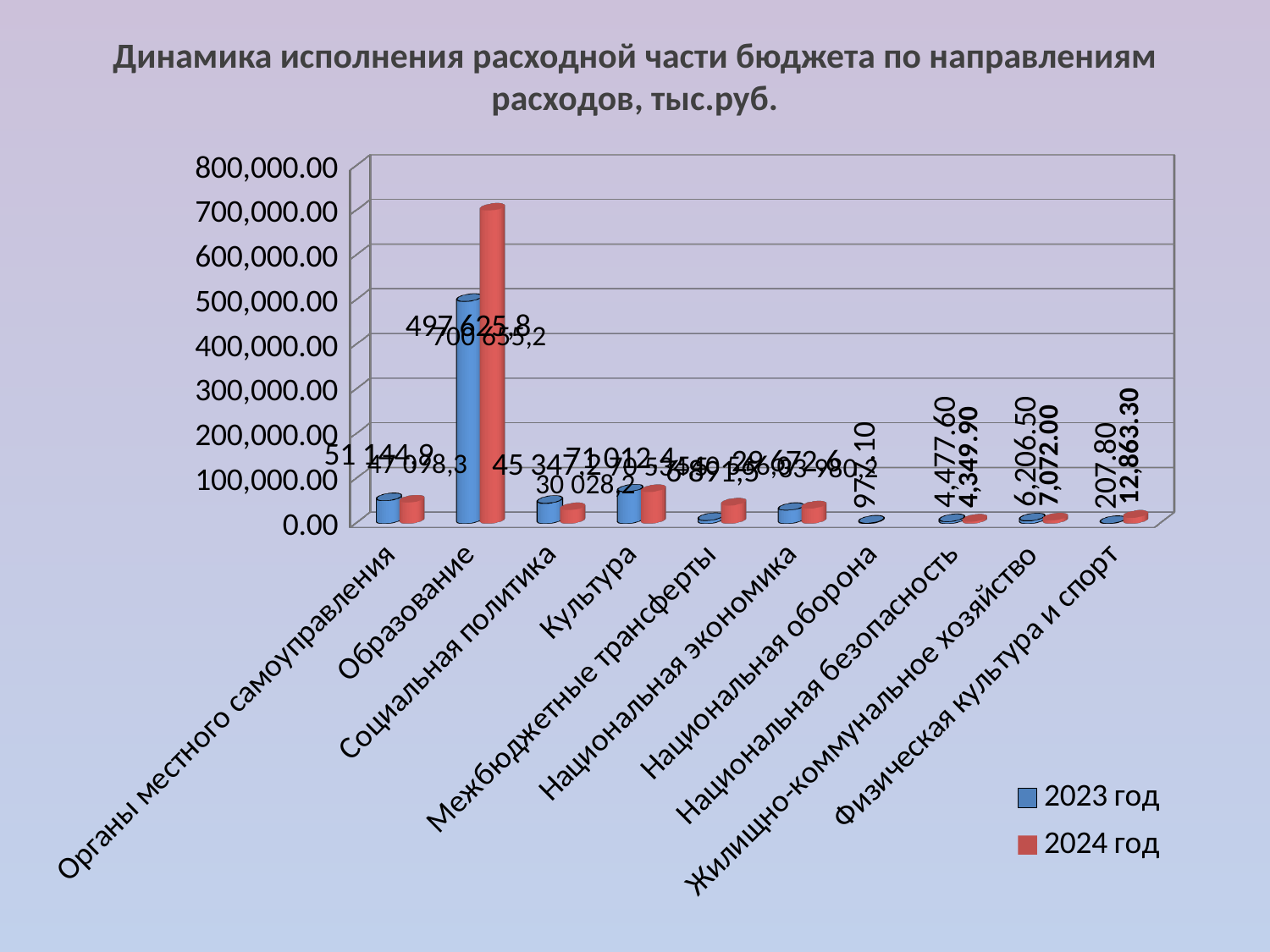
Is the 2024 год value for Образование greater or less than 600,000.00? greater What is the 2023 год value for Органы местного самоуправления? 51 144,9 What is the value for Образование in the 2024 год series? 700 655,2 What is the 2024 год value for Социальная политика? 30 028,2 How many series does the legend list? 2 Which category has the lowest value in the 2023 год series? Физическая культура и спорт For Жилищно-коммунальное хозяйство, which year has the larger value, 2023 год or 2024 год? 2024 год What is the 2024 год value for Физическая культура и спорт? 12,863.30 What is the difference between the 2024 год and 2023 год values for Образование? 203 029,4 Which category has the highest value in the 2024 год series? Образование How many expenditure categories are shown on the x axis? 10 What is the value for Образование in the 2023 год series? 497 625,8